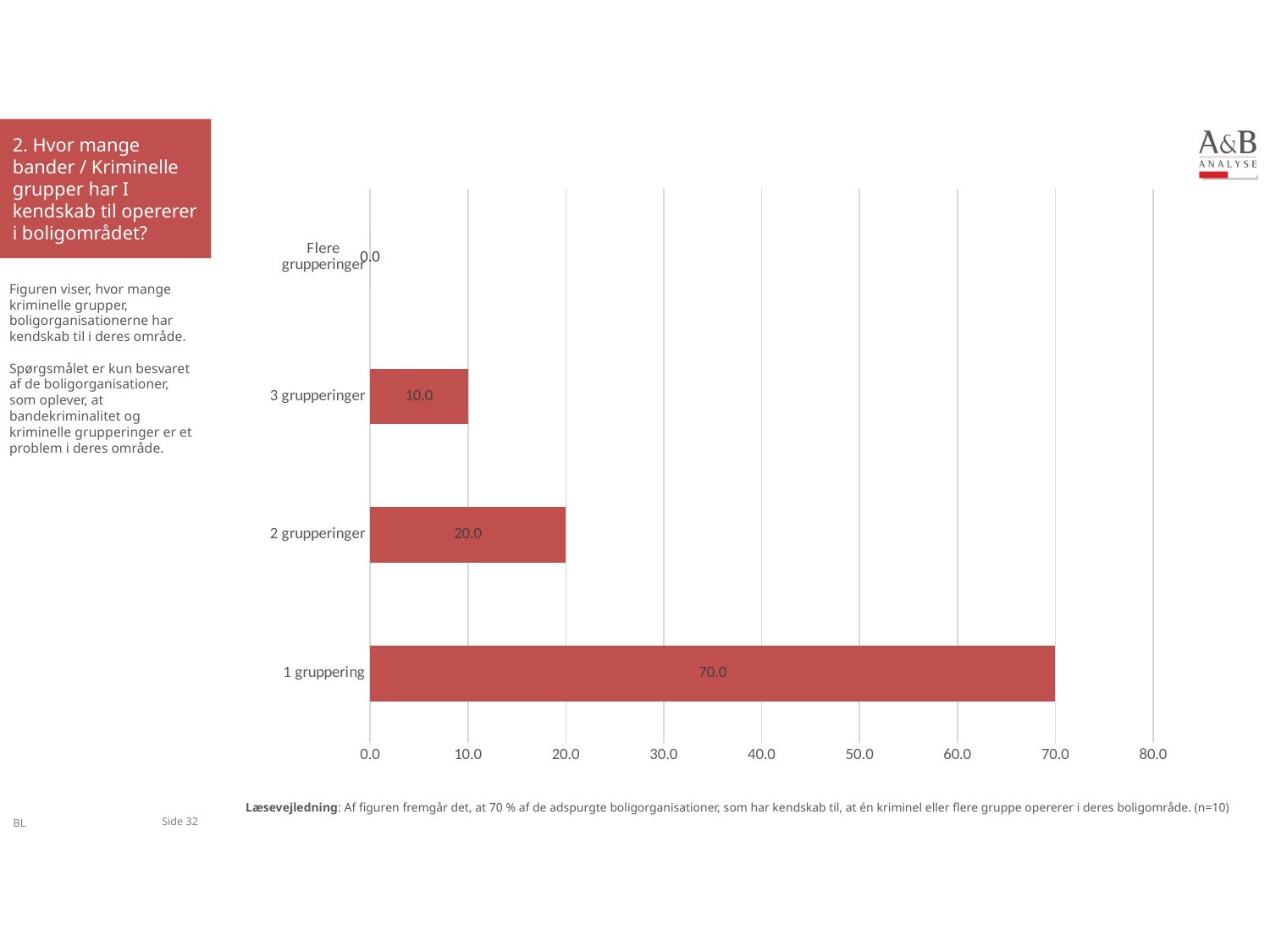
Which category has the highest value? 1 gruppering What is the value for "1 gruppering"? 70.0 What is the value for "3 grupperinger"? 10.0 What kind of chart is shown on the slide? bar chart Which category has the lowest value? Flere grupperinger What is the value for "Flere grupperinger"? 0.0 What is the highest value shown on the x axis? 80.0 What is the value for "2 grupperinger"? 20.0 Which is larger, the value for "2 grupperinger" or "3 grupperinger"? 2 grupperinger What is the difference between the values for "1 gruppering" and "2 grupperinger"? 50.0 Is the value for "1 gruppering" greater or less than 60.0? greater How many categories are shown in the chart? 4